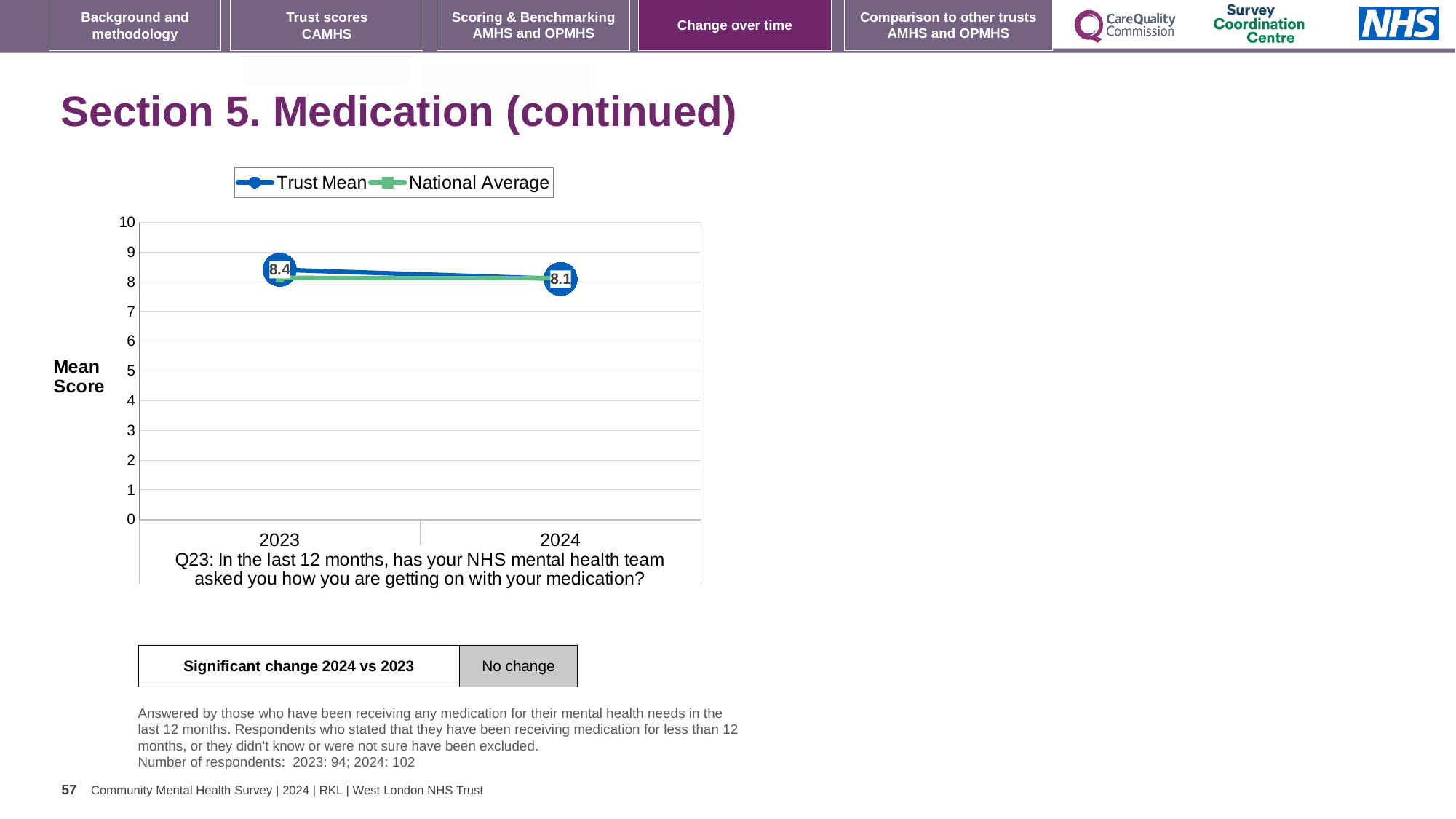
What kind of chart is shown on the slide? line chart Which is larger, the Trust Mean for 2023 or for 2024? 2023 What is the difference between the Trust Mean in 2023 and in 2024? 0.3 Is the National Average value for 2023 greater or less than 5? greater What is the label on the y axis of the chart? Mean Score In which year is the Trust Mean highest? 2023 What is the Trust Mean score for 2024? 8.1 Does the Trust Mean rise or fall from 2023 to 2024? fall What is the Trust Mean score for 2023? 8.4 How many series does the chart legend list? 2 How many years are shown on the x axis of the chart? 2 In which year is the Trust Mean lowest? 2024